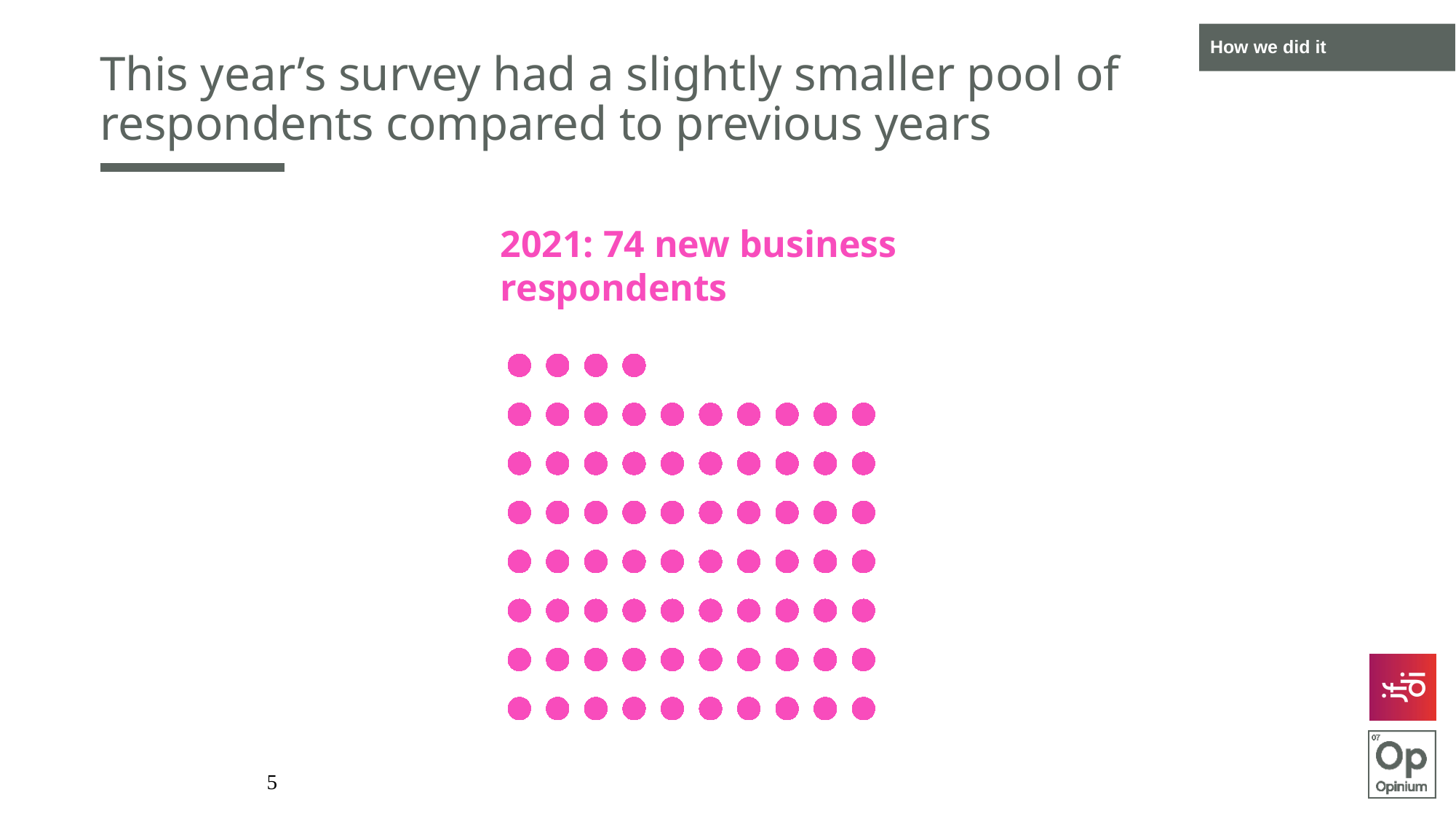
How many full rows of 10 dots does the chart contain? 7 Which year does the chart's label refer to? 2021 How many rows of dots does the chart have? 8 How many new business respondents did the 2021 survey have, according to the chart label? 74 How many dots are in the top (shortest) row of the chart? 4 What kind of chart is used to show the number of respondents? Pictogram (dot chart) What is the label printed above the dot chart? 2021: 74 new business respondents Is the number of new business respondents shown greater or less than 100? less What colour are the dots in the chart? Pink